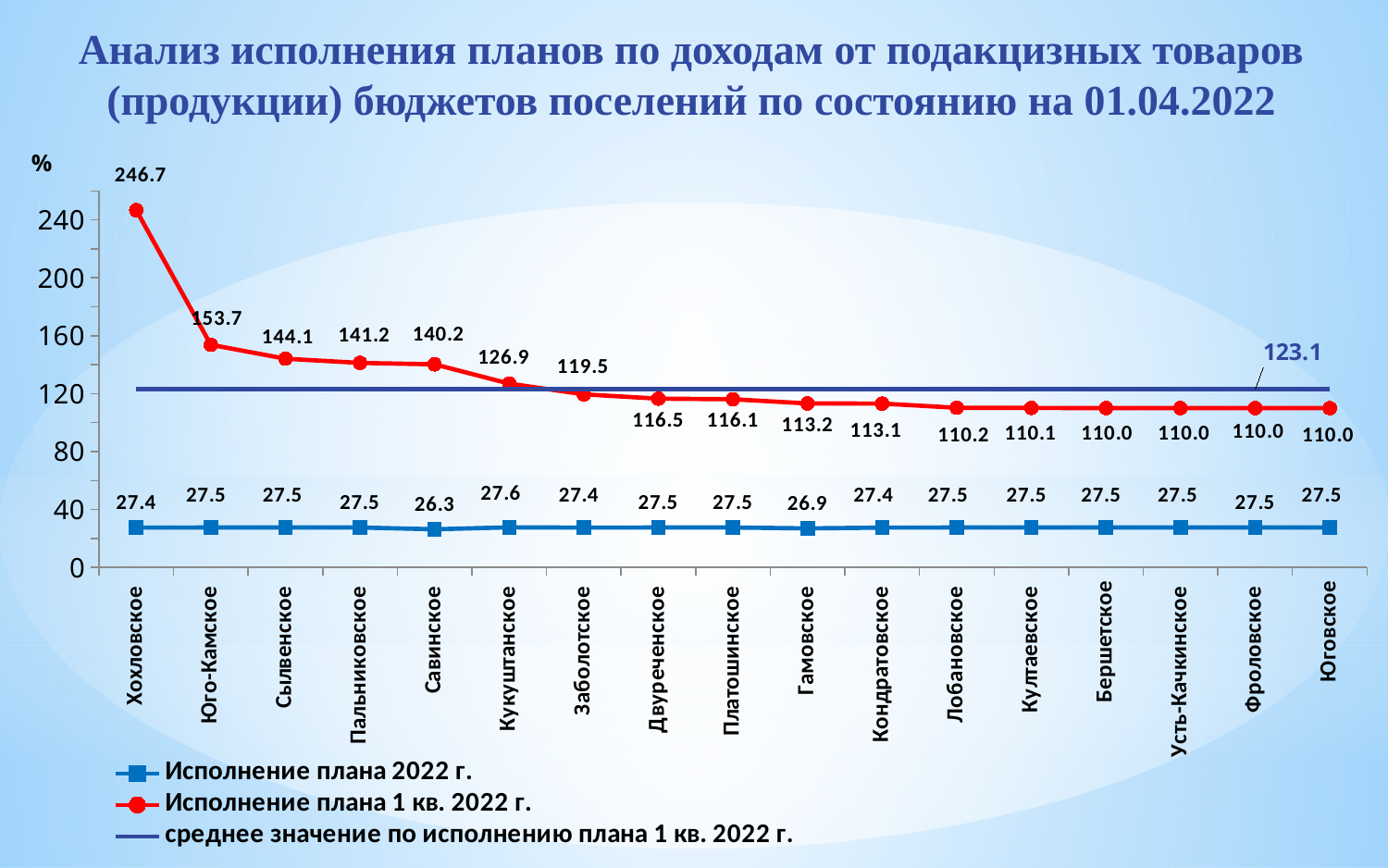
Which settlement has the highest value for "Исполнение плана 1 кв. 2022 г."? Хохловское Which is larger: the "Исполнение плана 1 кв. 2022 г." value for Кукуштанское or for Заболотское? Кукуштанское How many settlements are shown on the x axis? 17 What is the value of "Исполнение плана 2022 г." for Савинское? 26.3 What colour is the line for "Исполнение плана 1 кв. 2022 г."? Red Does the "Исполнение плана 1 кв. 2022 г." series rise or fall from left to right along the x axis? Fall What is the value of the line "среднее значение по исполнению плана 1 кв. 2022 г."? 123.1 How many series does the legend list? 3 Which settlement has the lowest value for "Исполнение плана 2022 г."? Савинское What kind of chart is shown on the slide? Line chart What is the difference between the "Исполнение плана 1 кв. 2022 г." values for Хохловское and Юго-Камское? 93.0 What is the value of "Исполнение плана 1 кв. 2022 г." for Хохловское? 246.7